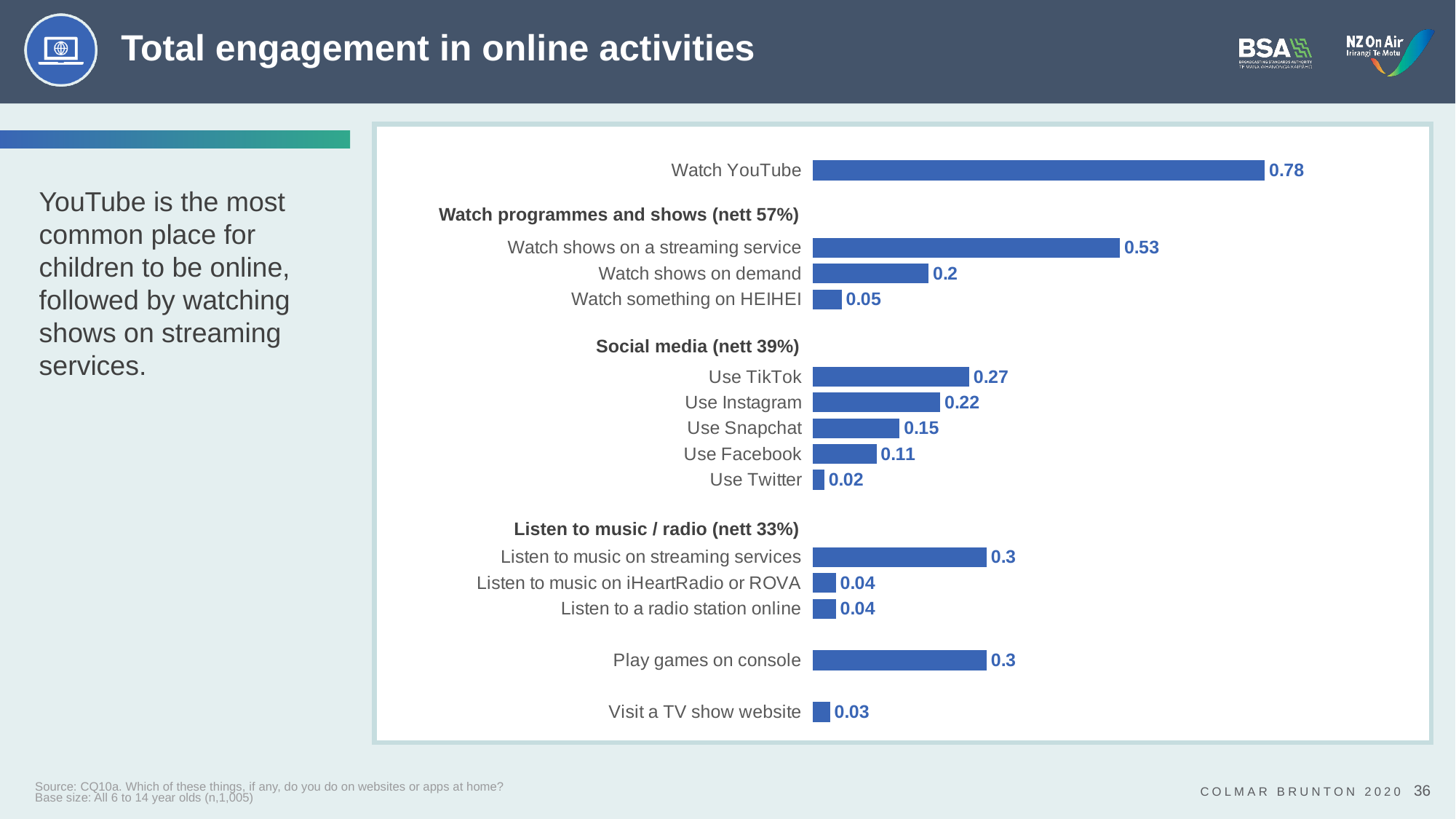
What is the value for Watch YouTube? 0.78 What is the difference between the values for Watch YouTube and Watch shows on a streaming service? 0.25 Which activity has the lowest value? Use Twitter Which is larger, the value for Use Facebook or the value for Use Snapchat? Use Snapchat What is the difference between the values for Use Instagram and Use Snapchat? 0.07 Which activity has the highest value? Watch YouTube What is the value for Use TikTok? 0.27 What nett percentage is shown for the Social media group heading? 39% What is the value for Listen to music on streaming services? 0.3 How many bars are plotted in the chart? 14 What is the value for Watch something on HEIHEI? 0.05 What kind of chart is shown on the slide? Bar chart